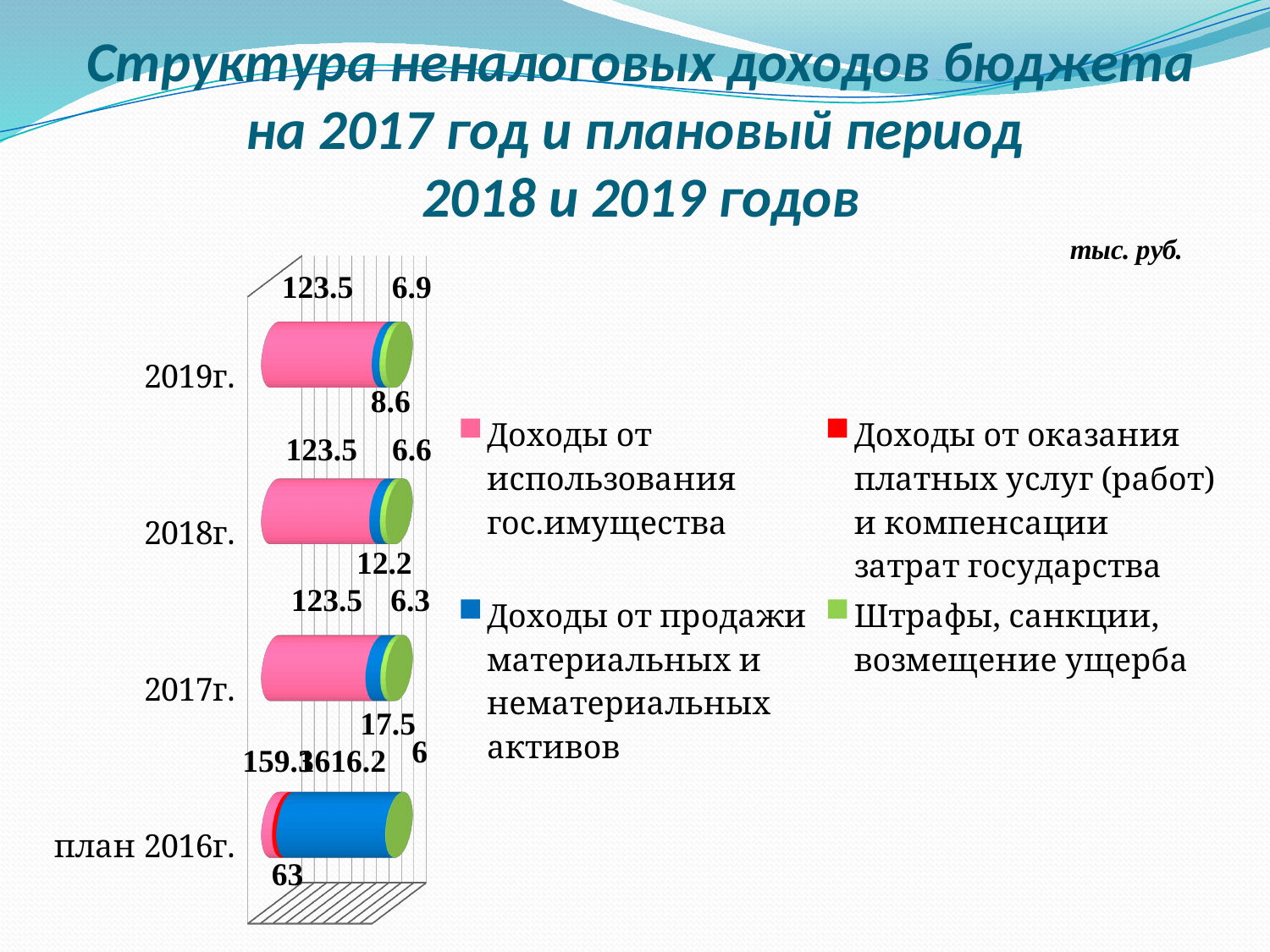
How many categories (years) are shown on the chart? 4 Which colour represents 'Доходы от продажи материальных и нематериальных активов' in the legend? blue What kind of chart is shown on the slide? bar chart What is the value of 'Штрафы, санкции, возмещение ущерба' for 2019г.? 6.9 What is the value of 'Доходы от использования гос.имущества' for 2017г.? 123.5 Which category is listed at the bottom of the chart? план 2016г. What is the value of 'Штрафы, санкции, возмещение ущерба' for 2017г.? 6.3 What is the value of 'Доходы от использования гос.имущества' for 2019г.? 123.5 In what units are the chart values given, according to the slide? тыс. руб. What is the value of 'Доходы от использования гос.имущества' for 2018г.? 123.5 Does the value of 'Штрафы, санкции, возмещение ущерба' rise or fall from 2017г. to 2019г.? rise How many series does the legend list? 4